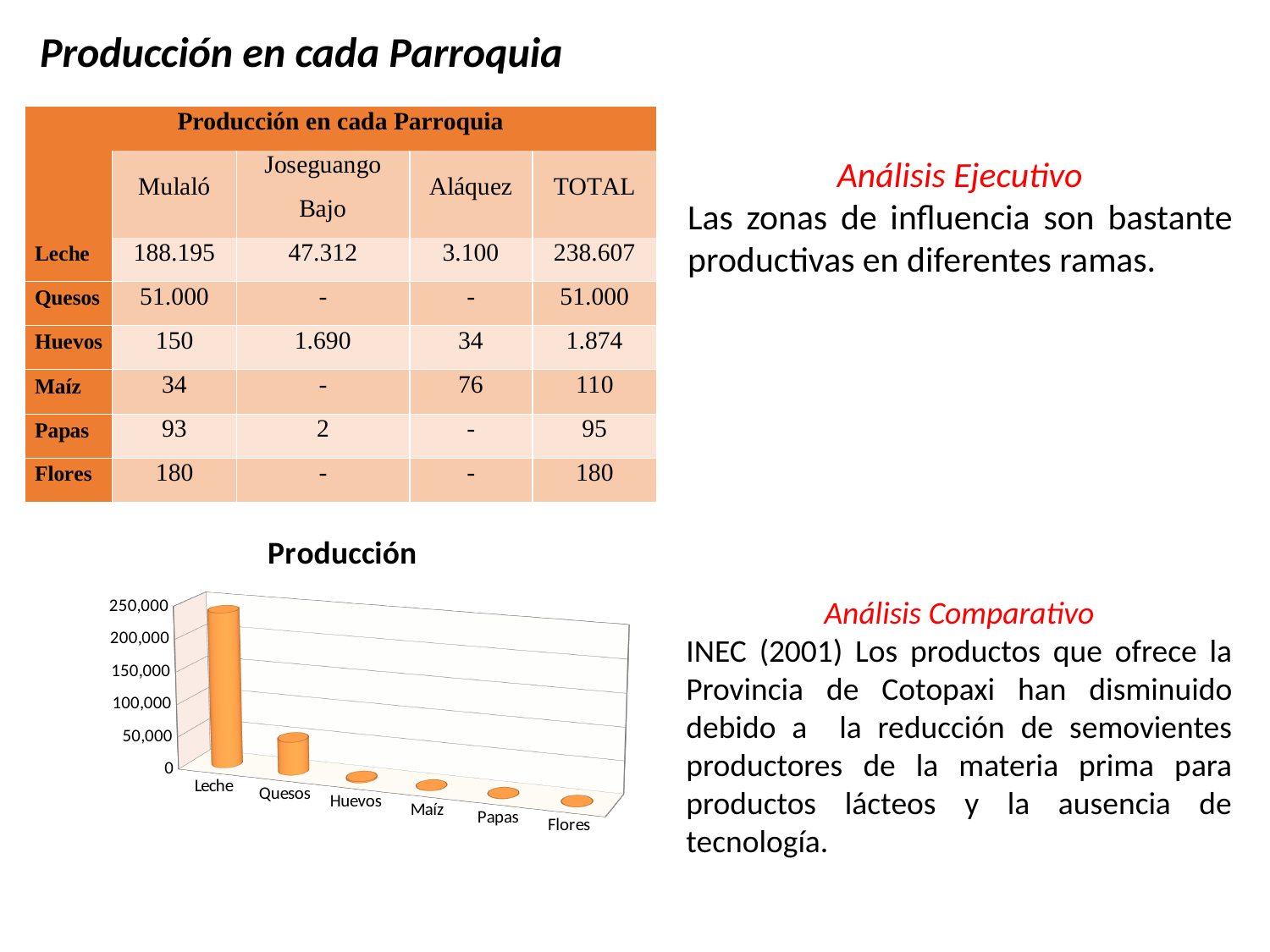
How many categories are shown on the x axis of the "Producción" chart? 6 In the "Producción" chart, is the value for Quesos greater or less than 100,000? less Which category is listed first on the x axis of the "Producción" chart? Leche What is the highest value shown on the vertical axis of the "Producción" chart? 250,000 In the "Producción" chart, which is larger, the value for Quesos or the value for Huevos? Quesos In the "Producción" chart, is the value for Huevos greater or less than 50,000? less Which category has the highest bar in the "Producción" chart? Leche In the "Producción" chart, is the value for Leche greater or less than 200,000? greater What is the title of the chart on the slide? Producción What kind of chart is the "Producción" chart? bar chart In the "Producción" chart, which is larger, the value for Leche or the value for Quesos? Leche